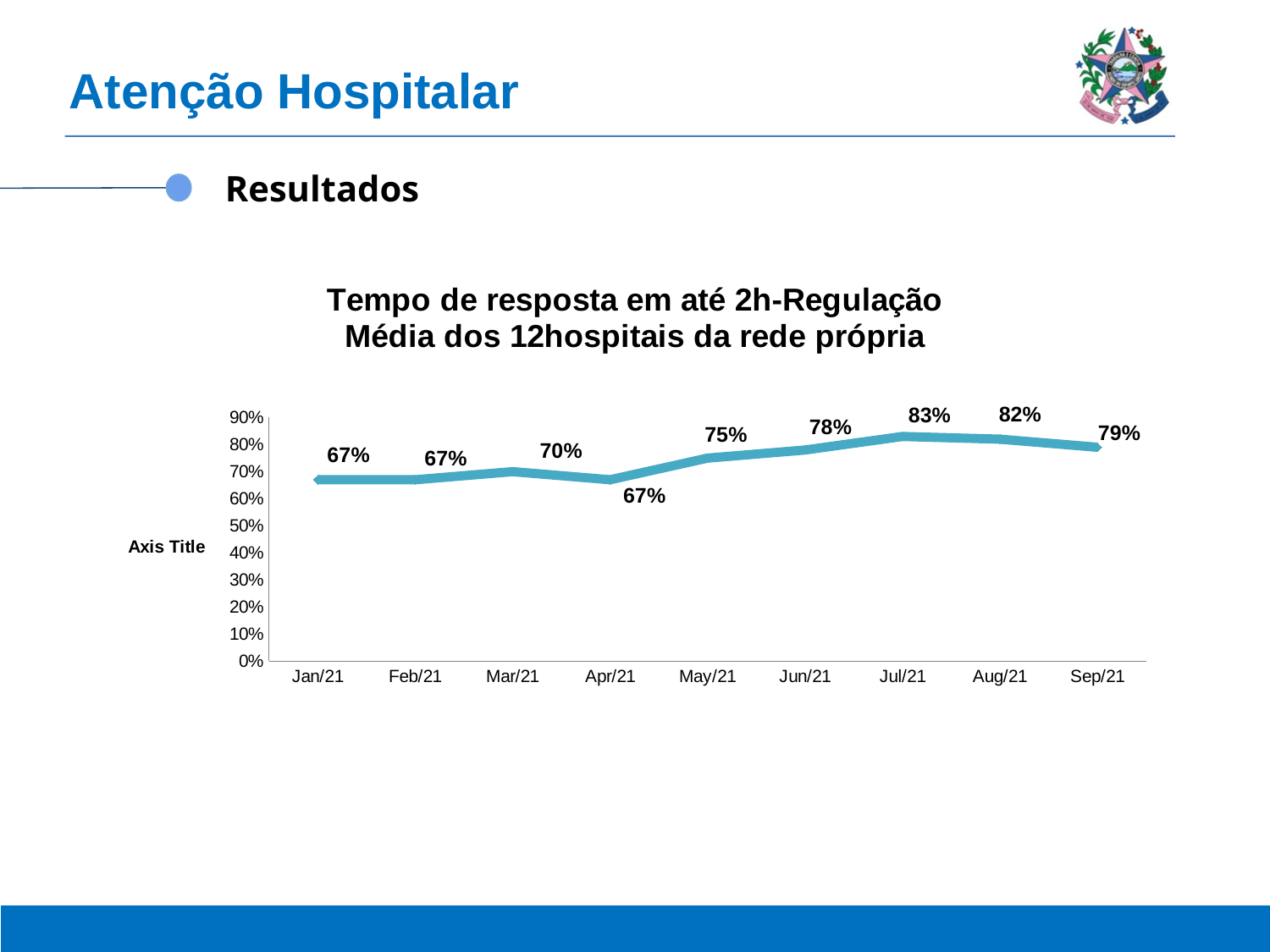
What is the title of the chart? Tempo de resposta em até 2h-Regulação Média dos 12hospitais da rede própria How many months are plotted on the x axis? 9 Which is larger, the value for Aug/21 or the value for Sep/21? Aug/21 What is the difference between the values for Jul/21 and Jan/21? 16% What is the value for Jul/21? 83% What is the value for Sep/21? 79% What is the difference between the values for Jun/21 and May/21? 3% What kind of chart is shown? line chart Do the values generally rise or fall from Jan/21 to Jul/21? rise What is the value for Apr/21? 67% Which month has the highest value? Jul/21 Is the value for May/21 greater or less than 70%? greater